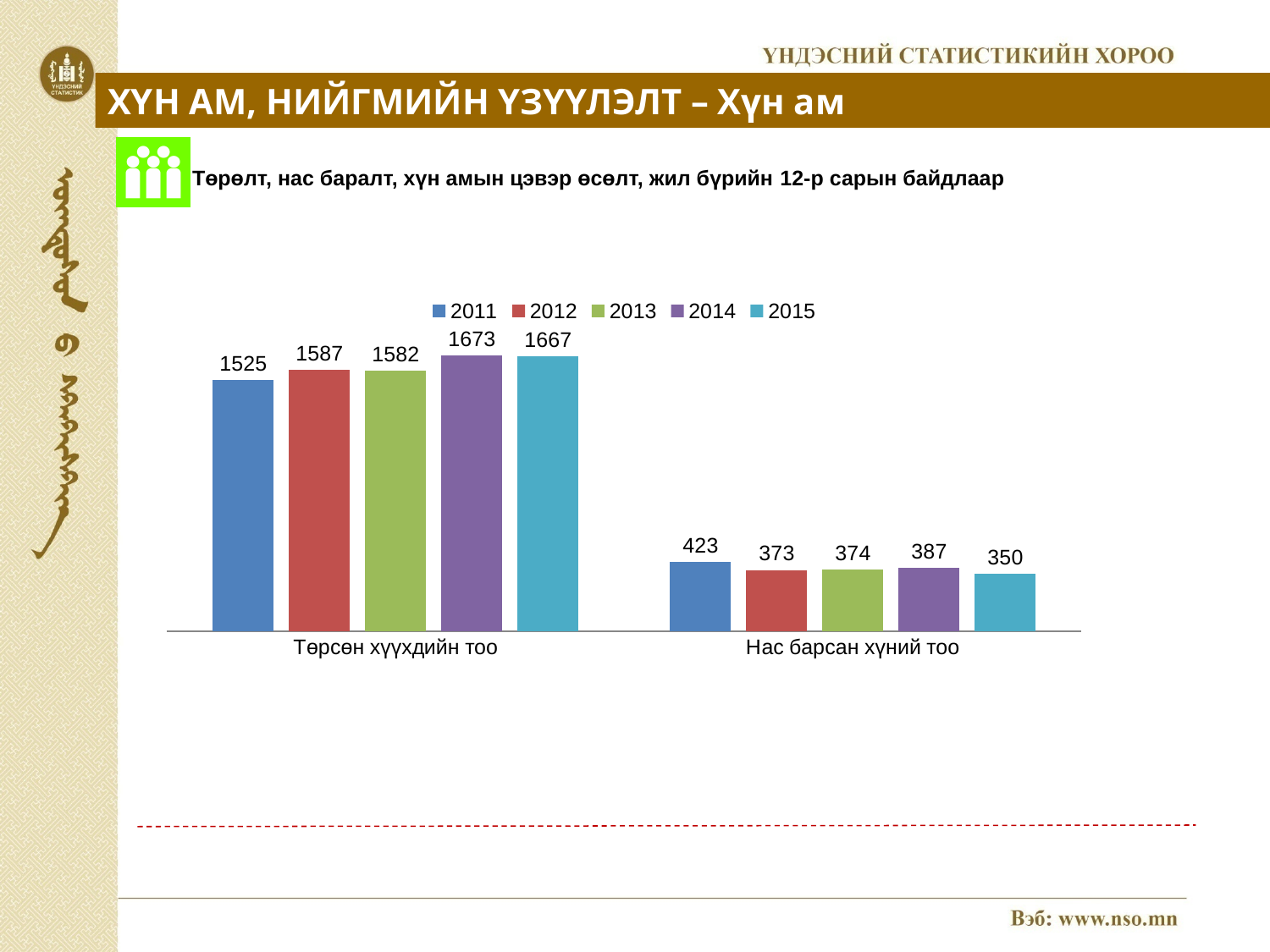
What is the difference between the 2011 and 2015 values in the "Нас барсан хүний тоо" category? 73 What kind of chart is shown on the slide? Bar chart Which year has the highest value in the "Төрсөн хүүхдийн тоо" category? 2014 How many series does the legend list? 5 How many categories are shown on the x axis? 2 Which colour represents the 2013 series in the legend? Green What is the difference between the 2014 and 2011 values in the "Төрсөн хүүхдийн тоо" category? 148 What is the value for 2011 in the "Төрсөн хүүхдийн тоо" category? 1525 Which year has the lowest value in the "Нас барсан хүний тоо" category? 2015 What is the value for 2015 in the "Нас барсан хүний тоо" category? 350 In the "Нас барсан хүний тоо" category, which is larger: the 2011 value or the 2014 value? 2011 What is the value for 2014 in the "Төрсөн хүүхдийн тоо" category? 1673